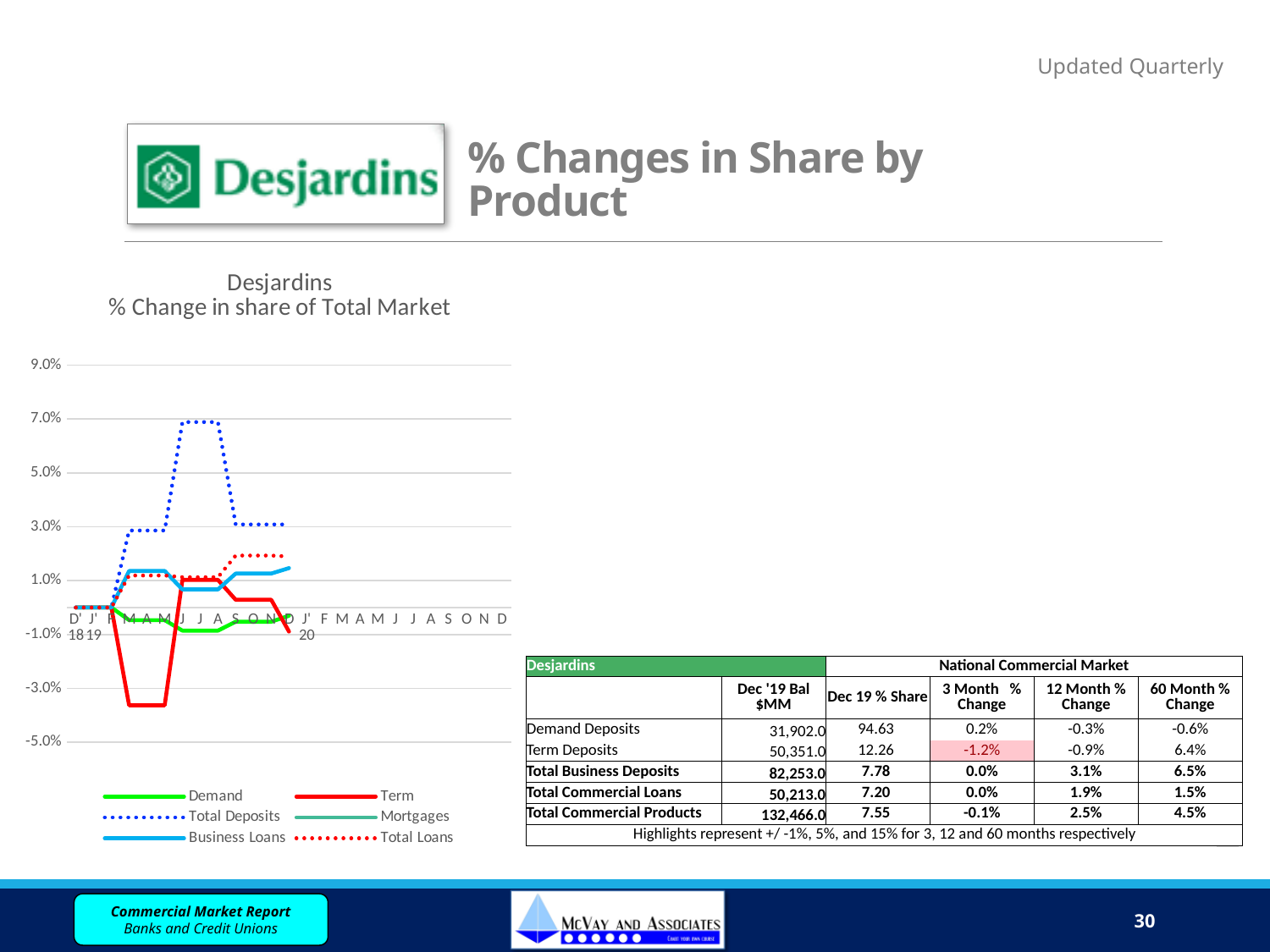
How many series does the chart legend list? 6 What is the title of the chart? Desjardins % Change in share of Total Market What kind of chart is shown on the slide? line chart Is the peak value of the Total Deposits line greater or less than 5.0%? greater Is the value of the Total Deposits line at the end of 2019 greater or less than 1.0%? greater What is the highest value shown on the chart's vertical axis? 9.0% Is the lowest value of the Term line greater or less than -3.0%? less In mid-2019, which line is higher: Total Deposits or Term? Total Deposits Which series reaches the lowest value on the chart? Term Which series reaches the highest value on the chart? Total Deposits Does the Total Deposits line rise or fall between January 2019 and May 2019? rise Which series is drawn as a blue dotted line in the chart? Total Deposits